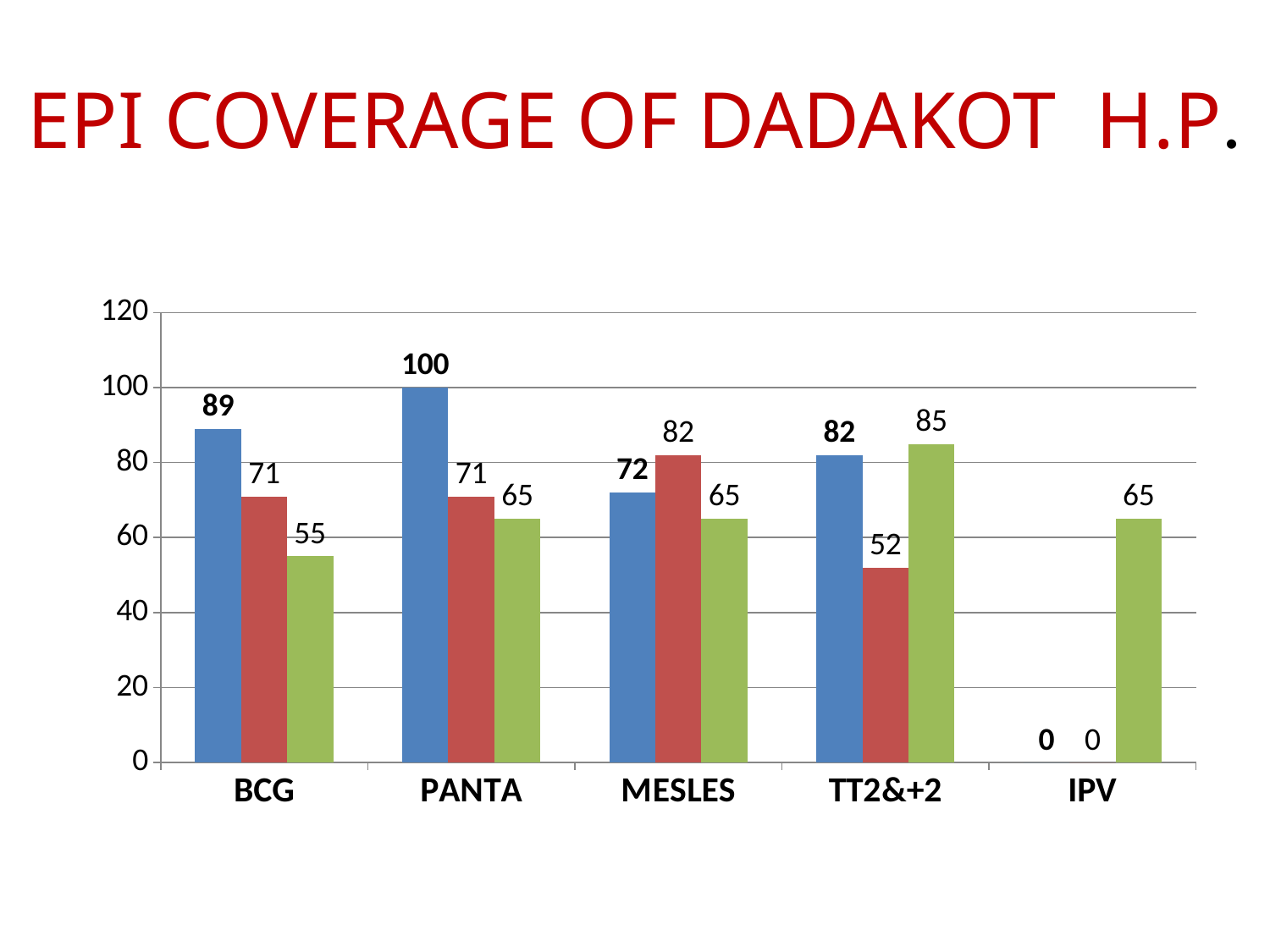
What is the title of the slide? EPI COVERAGE OF DADAKOT H.P. Which category has the lowest green bar? BCG What is the value of the blue bar for BCG? 89 What is the value of the green bar for TT2&+2? 85 How many bars are plotted for each category? 3 Which is larger for TT2&+2, the red bar or the green bar? the green bar What is the value of the red bar for MESLES? 82 What kind of chart is shown on the slide? bar chart What is the value of the blue bar for IPV? 0 How many categories are shown on the x axis? 5 Which category has the highest blue bar? PANTA What is the difference between the blue bar and the green bar for BCG? 34